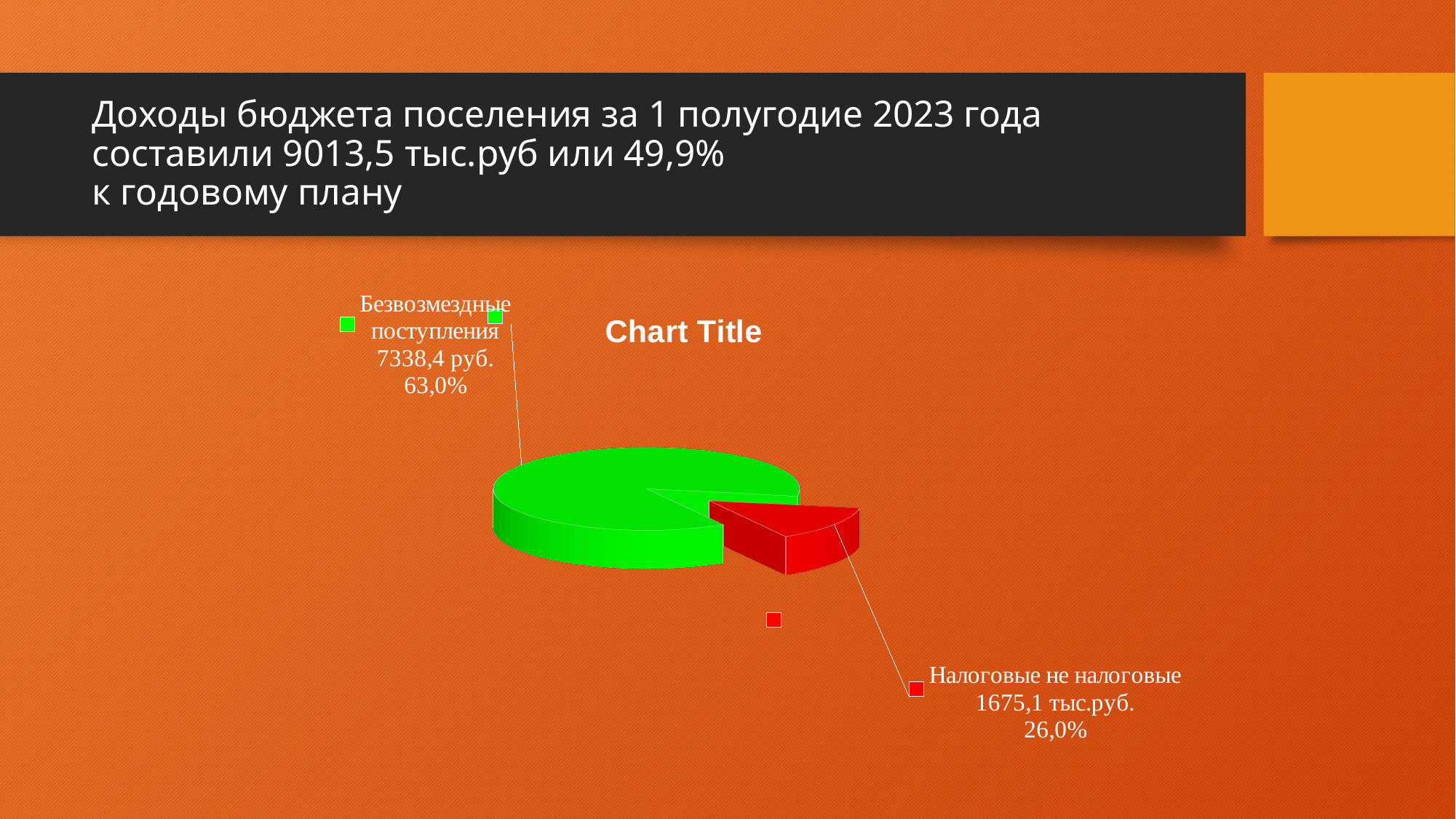
What value is shown for Налоговые не налоговые? 1675,1 тыс.руб. What is the chart's title? Chart Title What colour is the slice for Налоговые не налоговые? red What is the difference in percentage points between the share of Безвозмездные поступления and the share of Налоговые не налоговые? 37,0% Which slice is the largest? Безвозмездные поступления What share of the pie does Налоговые не налоговые represent? 26,0% What share of the pie does Безвозмездные поступления represent? 63,0% How many slices does the pie chart have? 2 Which is larger, Безвозмездные поступления or Налоговые не налоговые? Безвозмездные поступления What kind of chart is shown on the slide? pie chart What value is shown for Безвозмездные поступления? 7338,4 руб. Which slice is the smallest? Налоговые не налоговые